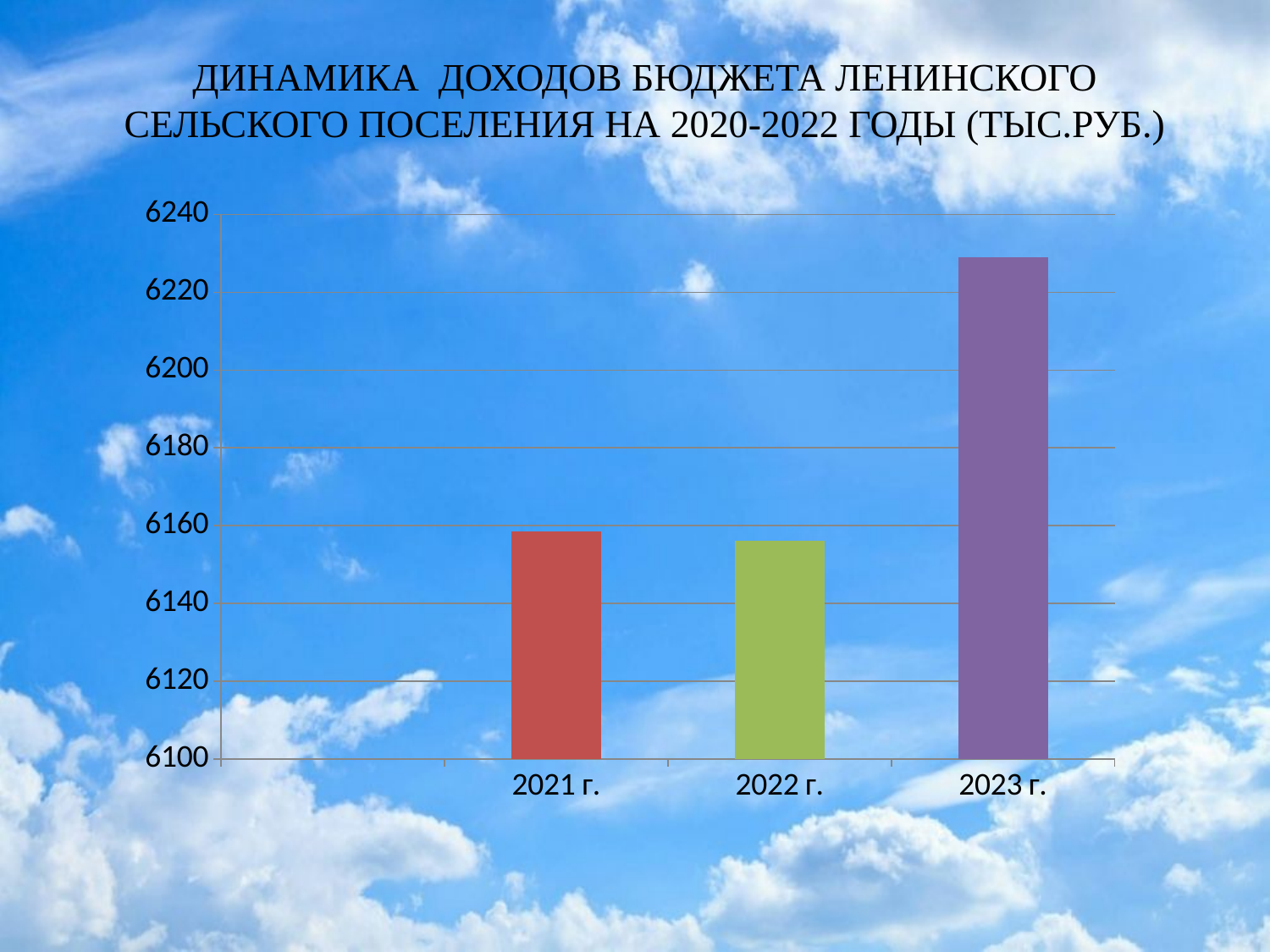
Which is larger, the value for 2023 г. or the value for 2021 г.? 2023 г. Does the value rise or fall from 2022 г. to 2023 г.? rise What colour is the bar for 2023 г.? purple What kind of chart is shown on the slide? bar chart What is the lowest value shown on the vertical axis? 6100 Is the value for 2023 г. greater or less than 6220? greater How many categories (years) are plotted on the chart? 3 Is the value for 2023 г. greater or less than 6240? less Is the value for 2021 г. greater or less than 6140? greater Which year has the highest budget income on the chart? 2023 г.